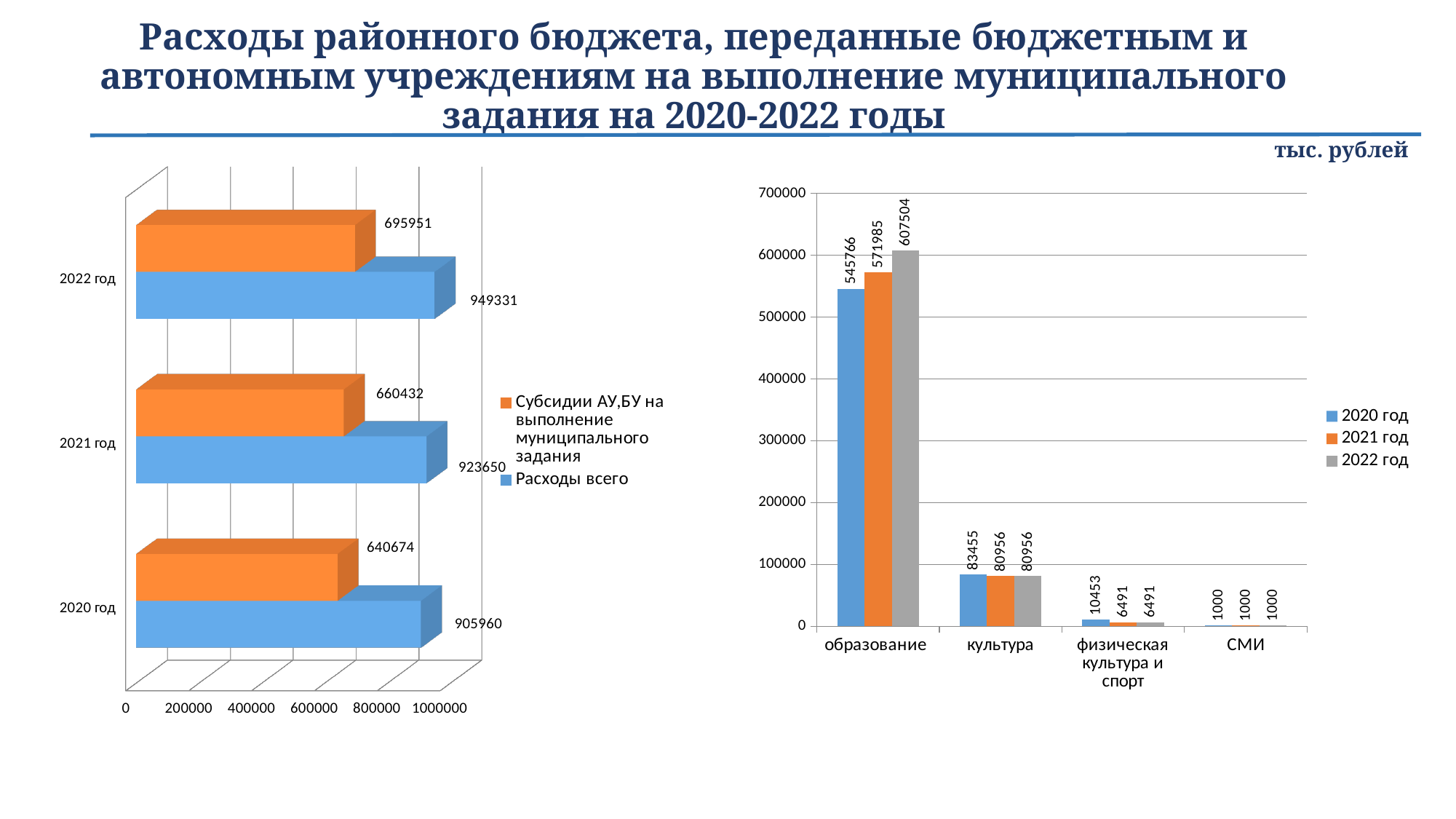
In the left chart, what is the value of 'Расходы всего' for 2022 год? 949331 In the right chart, which category has the highest values? образование In the left chart, which year has the lowest value for 'Субсидии АУ,БУ на выполнение муниципального задания'? 2020 год In the left chart, how many series does the legend list? 2 In the left chart, what is the difference between 'Расходы всего' and 'Субсидии АУ,БУ на выполнение муниципального задания' for 2021 год? 263218 In the right chart, what is the value for 'образование' in 2022 год? 607504 What kind of chart is the right chart? bar chart In the right chart, how many categories are shown on the x axis? 4 In the right chart, what is the difference between the 2022 год and 2020 год values for 'образование'? 61738 In the right chart, what is the value for 'физическая культура и спорт' in 2020 год? 10453 In the left chart, what is the value of 'Субсидии АУ,БУ на выполнение муниципального задания' for 2020 год? 640674 In the left chart, do the 'Расходы всего' values rise or fall from 2020 год to 2022 год? rise